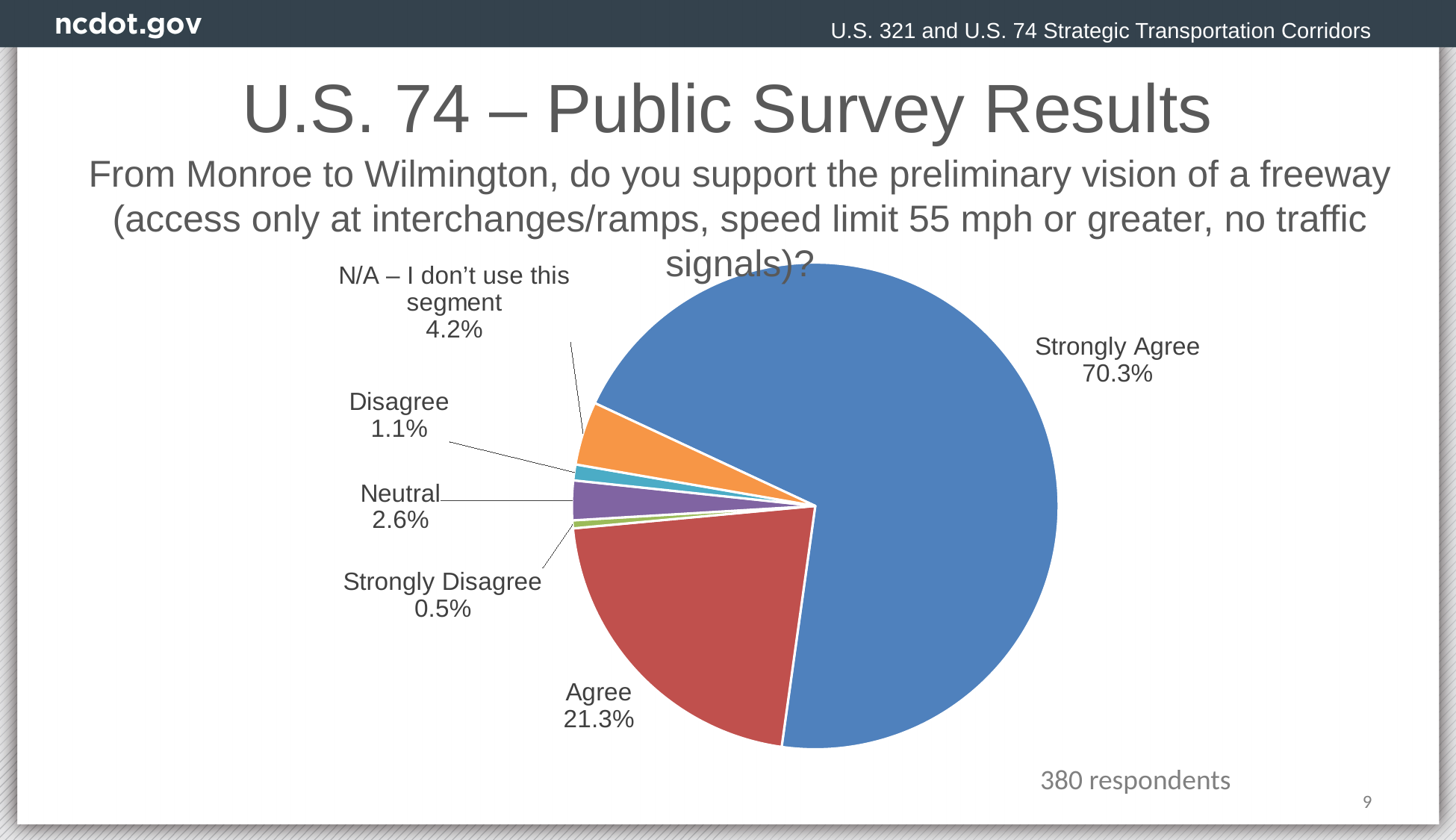
What is the combined share of Disagree and Strongly Disagree? 1.6% Which response has the largest share of the pie? Strongly Agree What share of respondents answered Neutral? 2.6% What share of respondents answered Agree? 21.3% What is the difference in percentage points between Strongly Agree and Agree? 49.0 percentage points What share of respondents answered Strongly Agree? 70.3% Which response has the smallest share of the pie? Strongly Disagree What share of respondents chose N/A – I don't use this segment? 4.2% Which is larger, the share for Disagree or the share for Neutral? Neutral What kind of chart is shown on the slide? Pie chart How many respondents does the slide say took the survey? 380 respondents How many response categories are shown in the pie chart? 6